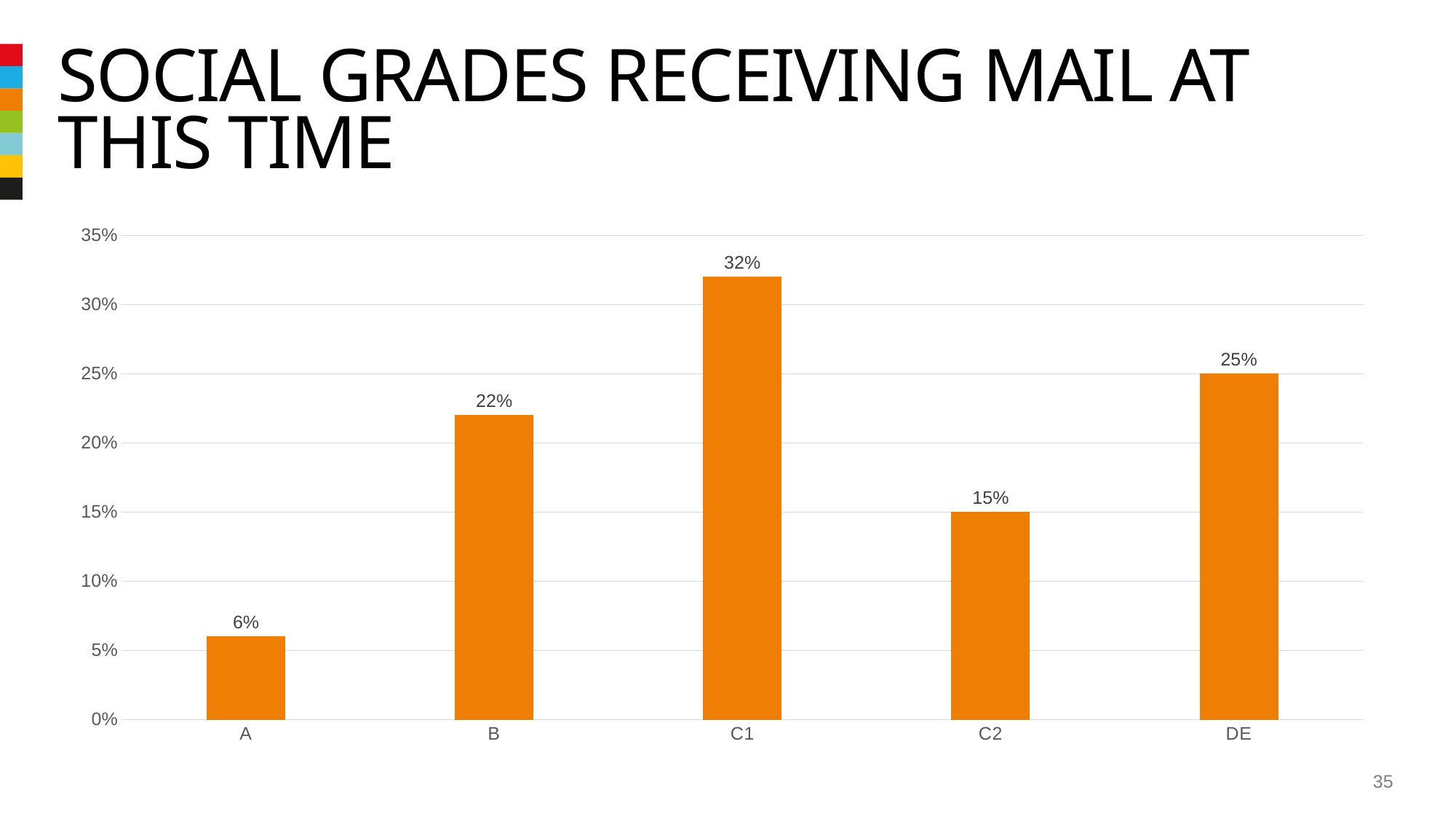
Which social grade has the highest value? C1 What is the difference between the values for B and A? 16% What is the value for social grade C1? 32% What is the difference between the values for C1 and C2? 17% Is the value for C2 greater or less than 20%? less What is the title of the slide? SOCIAL GRADES RECEIVING MAIL AT THIS TIME Which is larger, the value for B or the value for DE? DE What is the value for social grade DE? 25% What kind of chart is shown on the slide? bar chart Which social grade has the lowest value? A What is the value for social grade A? 6% How many social grades are shown on the x axis? 5